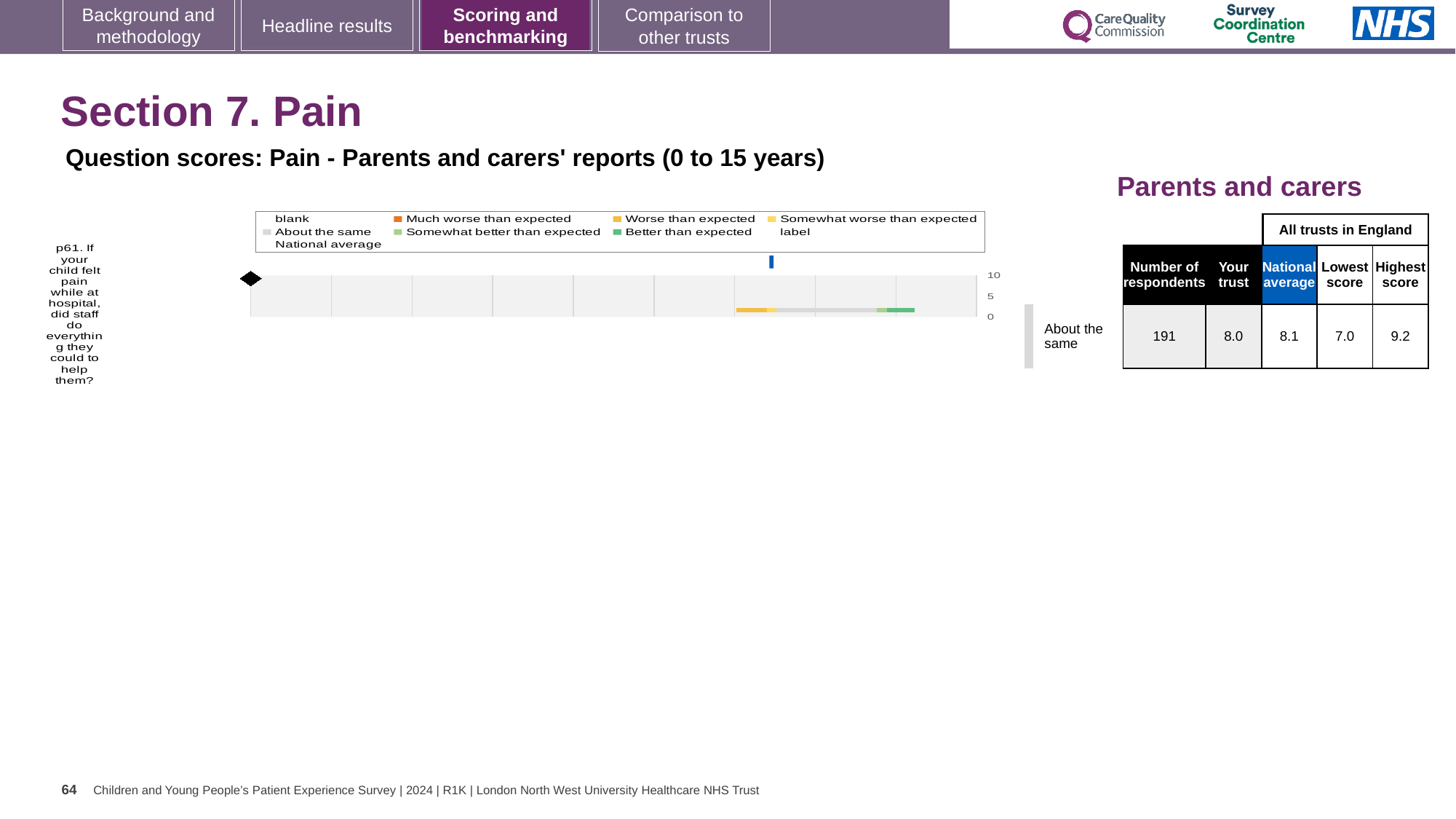
What kind of chart is shown on the slide? bar chart Which question is plotted in the chart? p61. If your child felt pain while at hospital, did staff do everything they could to help them? What is the difference between the highest score and the lowest score for question p61? 2.2 How many survey questions are plotted in the chart? 1 In the table beside the chart, what is the number of respondents for question p61? 191 What is the highest value shown on the chart's axis? 10 Is the 'Your trust' score or the national average score higher for question p61? National average In the table beside the chart, what is the national average score for question p61? 8.1 In the table beside the chart, what is the lowest score among all trusts in England for question p61? 7.0 In the table beside the chart, what is the 'Your trust' score for question p61? 8.0 How many entries does the chart legend list? 9 In the table beside the chart, what is the highest score among all trusts in England for question p61? 9.2